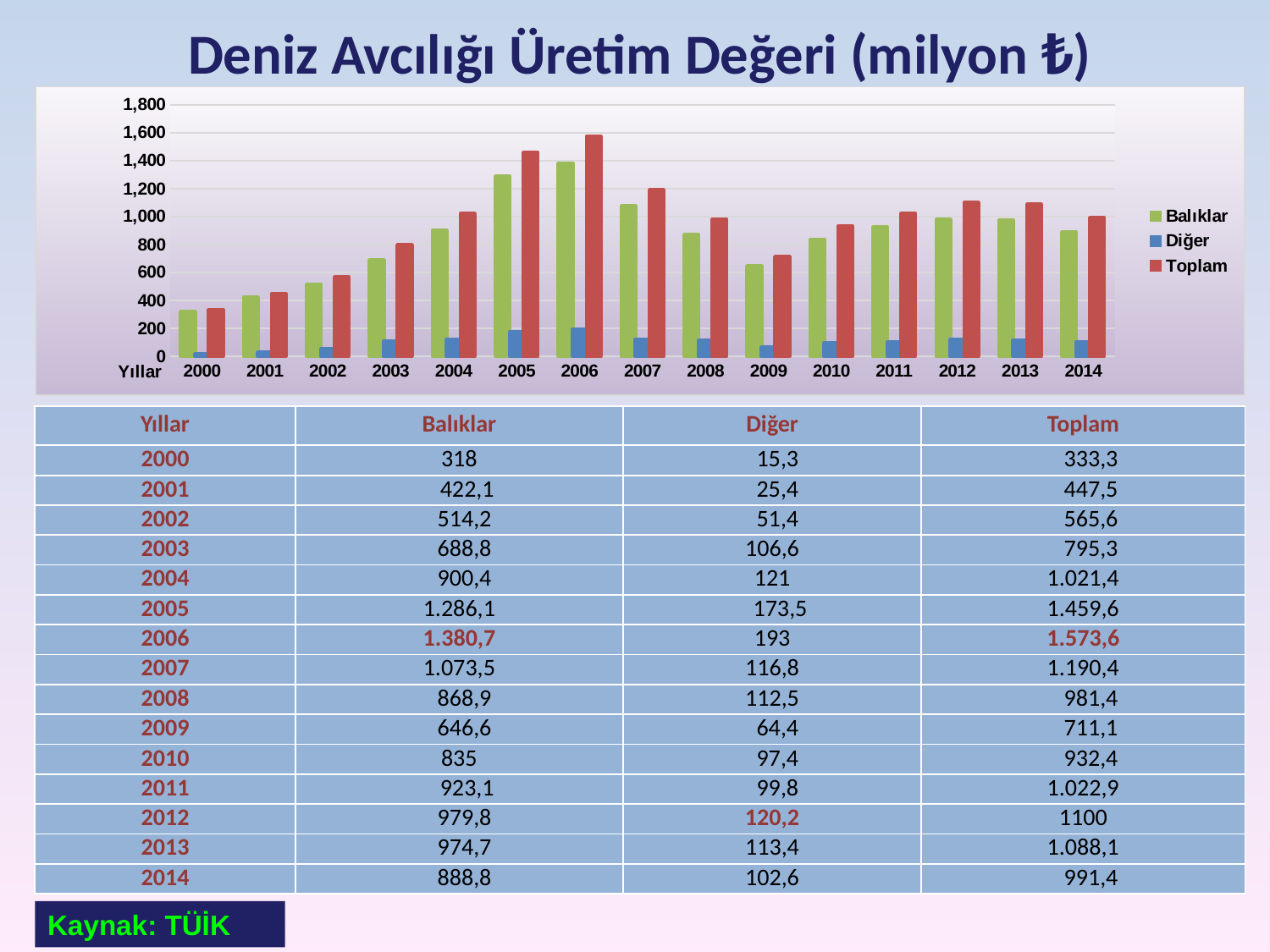
What type of chart is shown on the slide? bar chart How many years are shown on the x axis of the chart? 15 Is the Toplam value for 2009 greater or less than 800? less Which year has the lowest Balıklar value? 2000 What is the Toplam value for 2006? 1.573,6 Which year has the highest Toplam value? 2006 What is the Diğer value for 2012? 120,2 How many series does the chart legend list? 3 What is the Balıklar value for 2005? 1.286,1 What is the title of the chart? Deniz Avcılığı Üretim Değeri (milyon ₺) Which is larger, the Balıklar value for 2007 or the Balıklar value for 2008? 2007 Do the Toplam values rise or fall from 2000 to 2006? rise